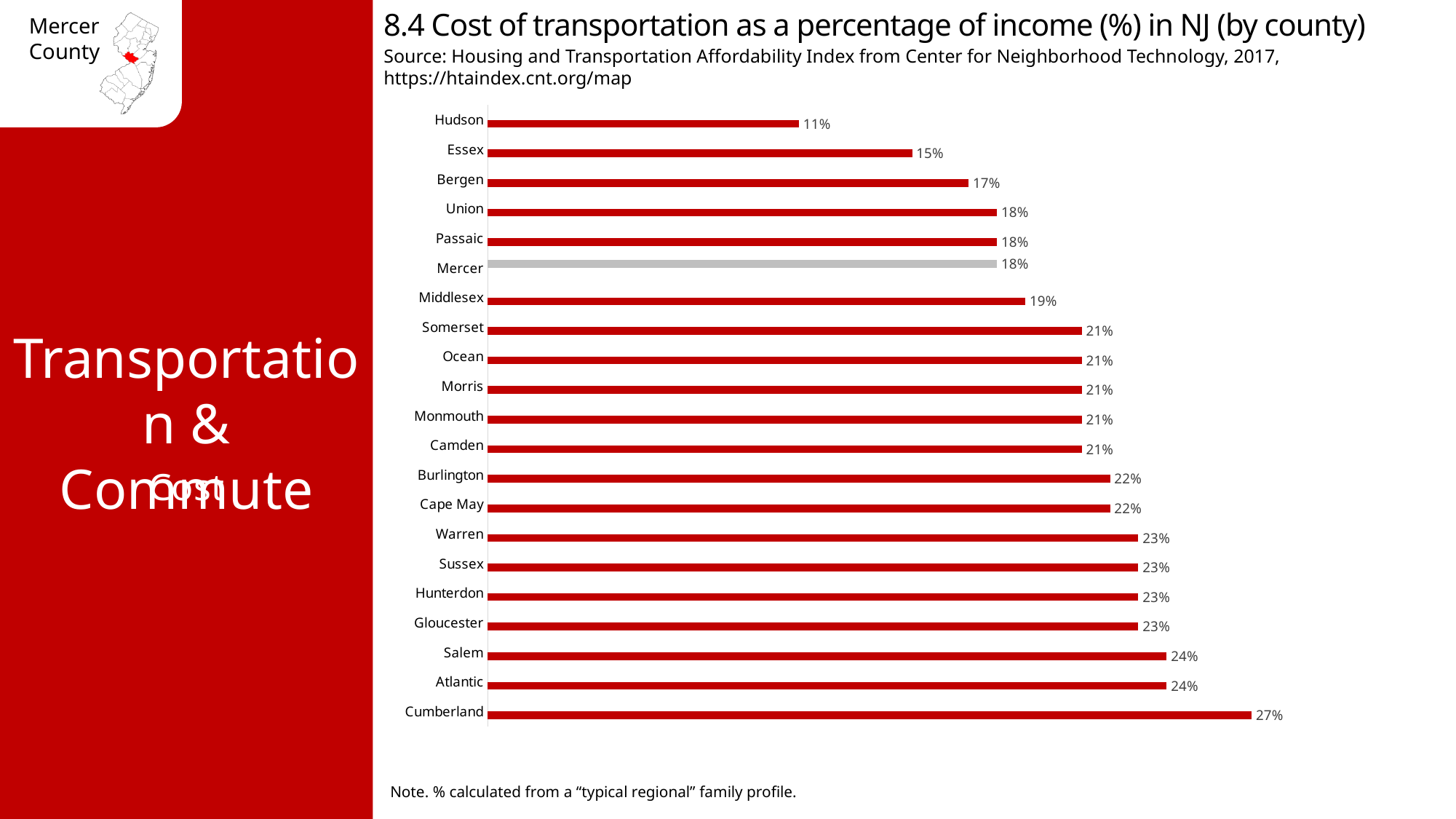
Which county has the highest cost of transportation as a percentage of income? Cumberland What is the difference between the values for Mercer and Essex? 3% How many counties are shown in the chart? 21 Which has a higher value, Salem or Warren? Salem What kind of chart is shown on the slide? Bar chart Which has a higher value, Bergen or Middlesex? Middlesex Which county has the lowest cost of transportation as a percentage of income? Hudson What is the cost of transportation as a percentage of income for Mercer County? 18% What is the value shown for Cumberland County? 27% Which county's bar is shown in a different colour (grey) from the others? Mercer What is the value shown for Hudson County? 11% What is the difference between the values for Cumberland and Hudson? 16%